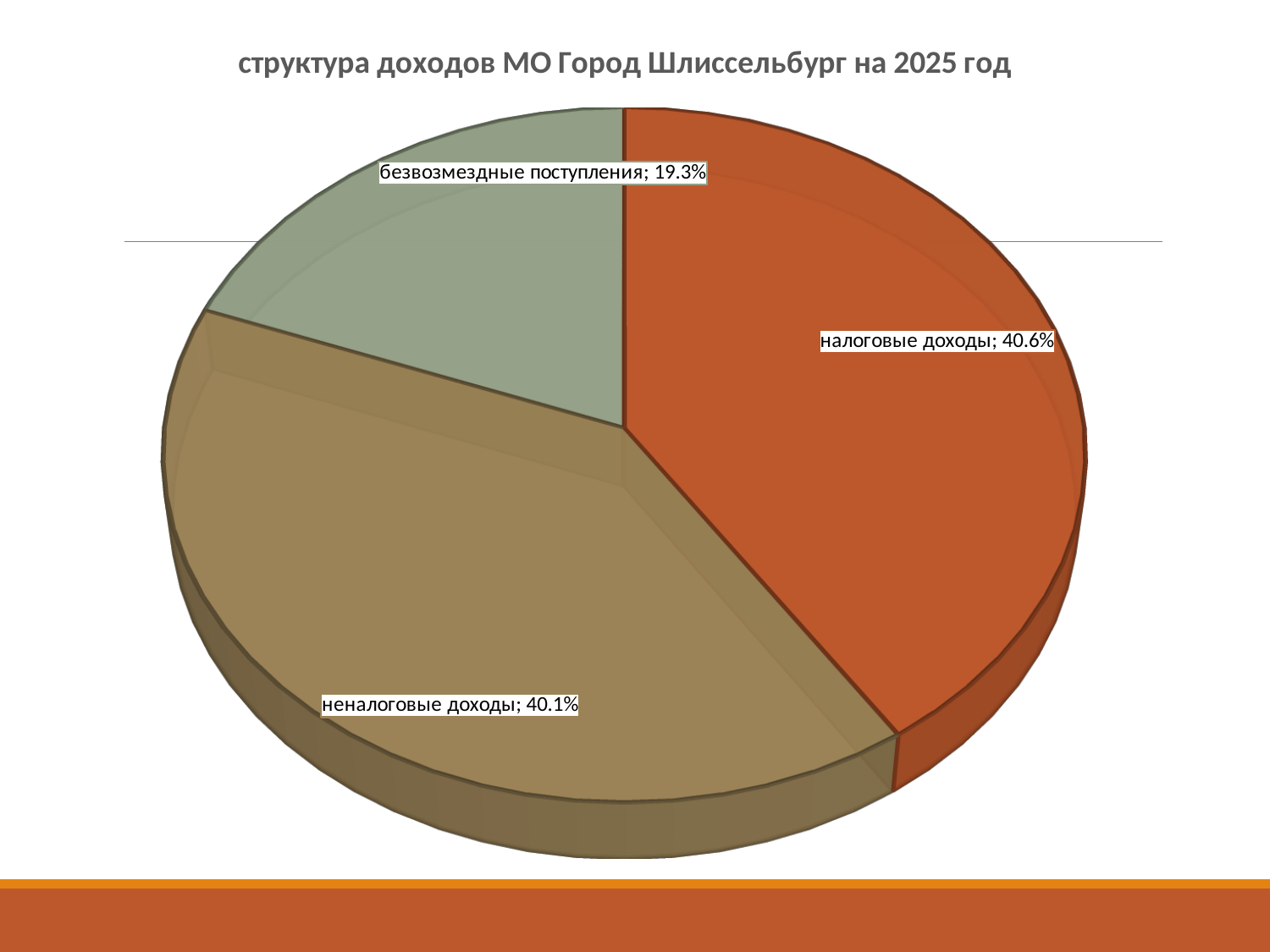
What share of the pie is безвозмездные поступления? 19.3% What share of the pie is неналоговые доходы? 40.1% Which category has the smallest share of the pie? безвозмездные поступления What kind of chart is shown on the slide? pie chart What is the difference in percentage points between налоговые доходы and безвозмездные поступления? 21.3 What share of the pie is налоговые доходы? 40.6% What is the title of the chart? структура доходов МО Город Шлиссельбург на 2025 год Which category has the largest share of the pie? налоговые доходы How many slices does the pie chart have? 3 What colour is the slice for налоговые доходы? orange-red What is the difference in percentage points between налоговые доходы and неналоговые доходы? 0.5 Which is larger: the share for налоговые доходы or the share for безвозмездные поступления? налоговые доходы